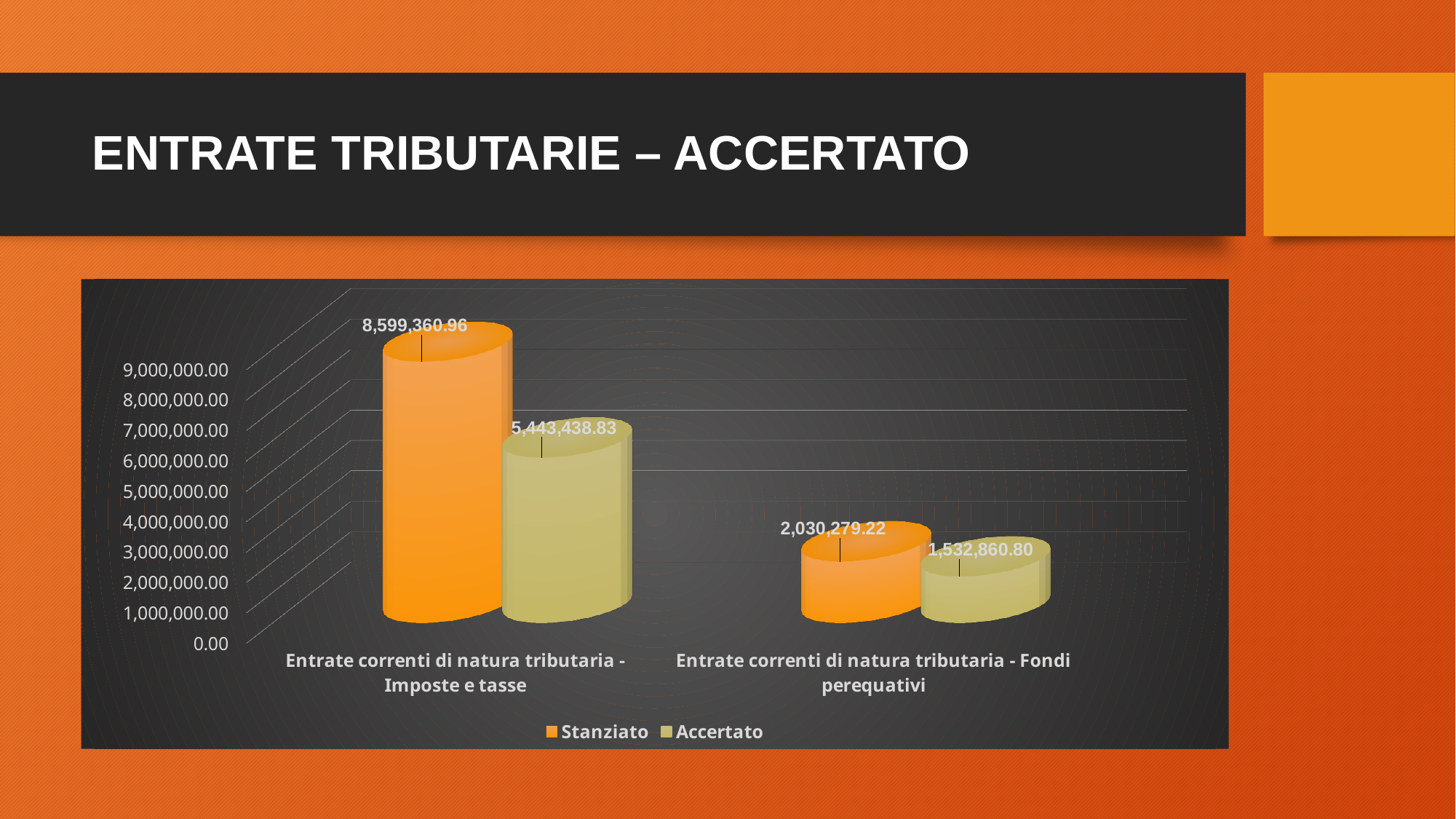
Which category has the highest Stanziato value? Entrate correnti di natura tributaria - Imposte e tasse How many categories are shown on the x axis of the chart? 2 How many series does the chart legend list? 2 Which is larger for Entrate correnti di natura tributaria - Fondi perequativi: Stanziato or Accertato? Stanziato What is the difference between the Stanziato and Accertato values for Entrate correnti di natura tributaria - Imposte e tasse? 3,155,922.13 What is the Accertato value for Entrate correnti di natura tributaria - Imposte e tasse? 5,443,438.83 What is the difference between the Stanziato and Accertato values for Entrate correnti di natura tributaria - Fondi perequativi? 497,418.42 Which category has the lowest Accertato value? Entrate correnti di natura tributaria - Fondi perequativi What is the Stanziato value for Entrate correnti di natura tributaria - Fondi perequativi? 2,030,279.22 What is the Stanziato value for Entrate correnti di natura tributaria - Imposte e tasse? 8,599,360.96 What is the Accertato value for Entrate correnti di natura tributaria - Fondi perequativi? 1,532,860.80 What kind of chart is shown on the slide? Bar chart